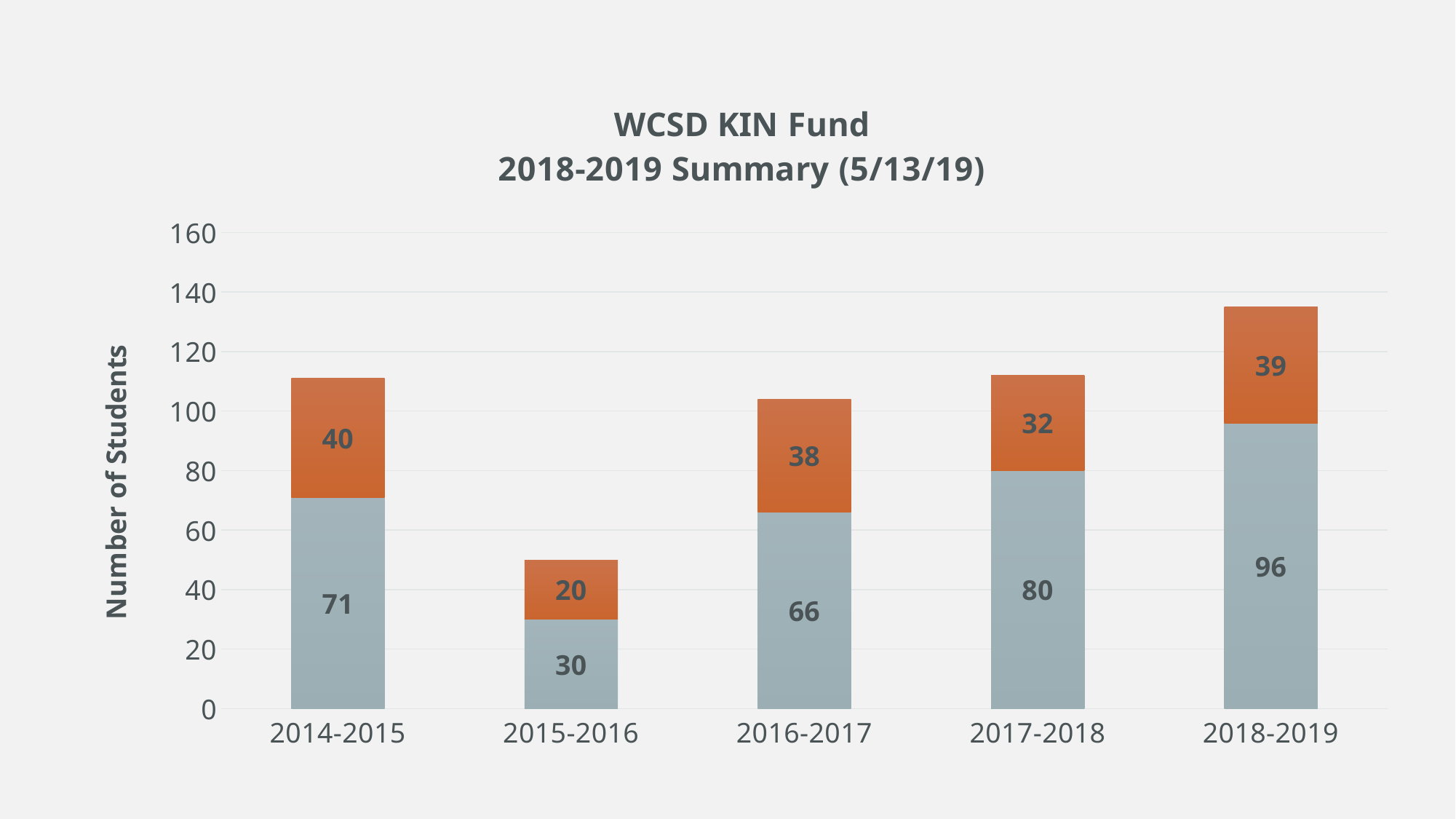
What kind of chart is shown on the slide? Stacked bar chart What is the total of the stacked bar for 2015-2016? 50 What is the label of the vertical axis? Number of Students Which is larger: the grey (bottom) segment for 2016-2017 or for 2017-2018? 2017-2018 What is the total of the stacked bar for 2018-2019? 135 What is the value of the orange (top) segment for 2017-2018? 32 What is the value of the grey (bottom) segment for 2018-2019? 96 Which year has the highest value for the orange (top) segment? 2014-2015 What is the value of the orange (top) segment for 2015-2016? 20 What is the difference between the grey (bottom) segment values for 2018-2019 and 2014-2015? 25 Which year has the lowest value for the grey (bottom) segment? 2015-2016 How many years are shown on the x axis? 5